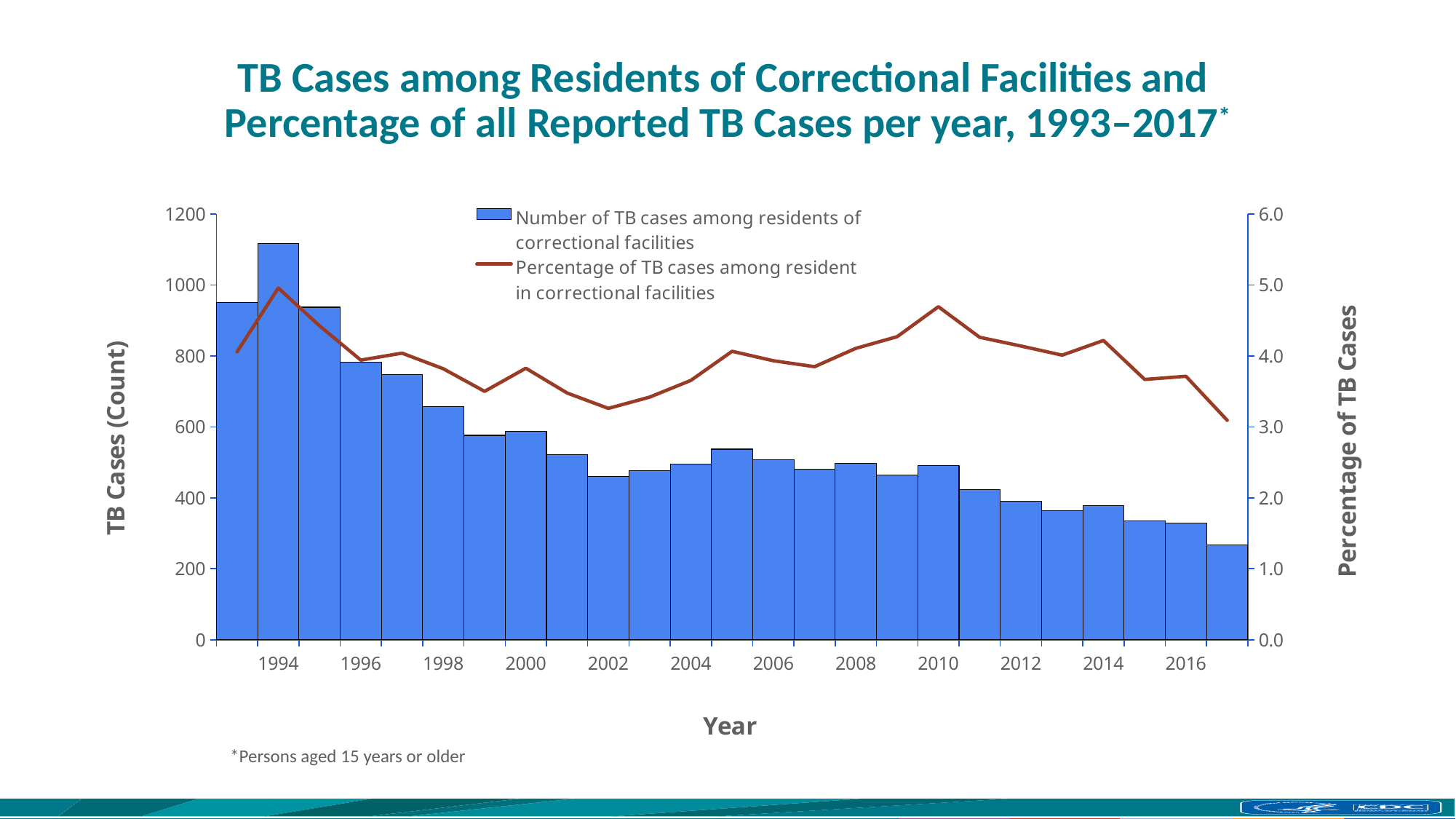
What kind of chart is shown on the slide? A combined bar and line chart Is the number of TB cases among residents of correctional facilities in 2017 greater or less than 400? less In which year is the percentage of TB cases among residents in correctional facilities highest? 1994 Which year has more TB cases among residents of correctional facilities, 1996 or 2000? 1996 How many series does the legend list? 2 Is the number of TB cases among residents of correctional facilities in 1994 greater or less than 1000? greater In which year is the percentage of TB cases among residents in correctional facilities lowest? 2017 In which year is the number of TB cases among residents of correctional facilities highest? 1994 How many years (bars) are plotted on the chart? 25 In which year is the number of TB cases among residents of correctional facilities lowest? 2017 Is the percentage of TB cases among residents in correctional facilities in 2010 greater or less than 4.0? greater What is the overall trend in the number of TB cases among residents of correctional facilities from 1994 to 2017? Falling